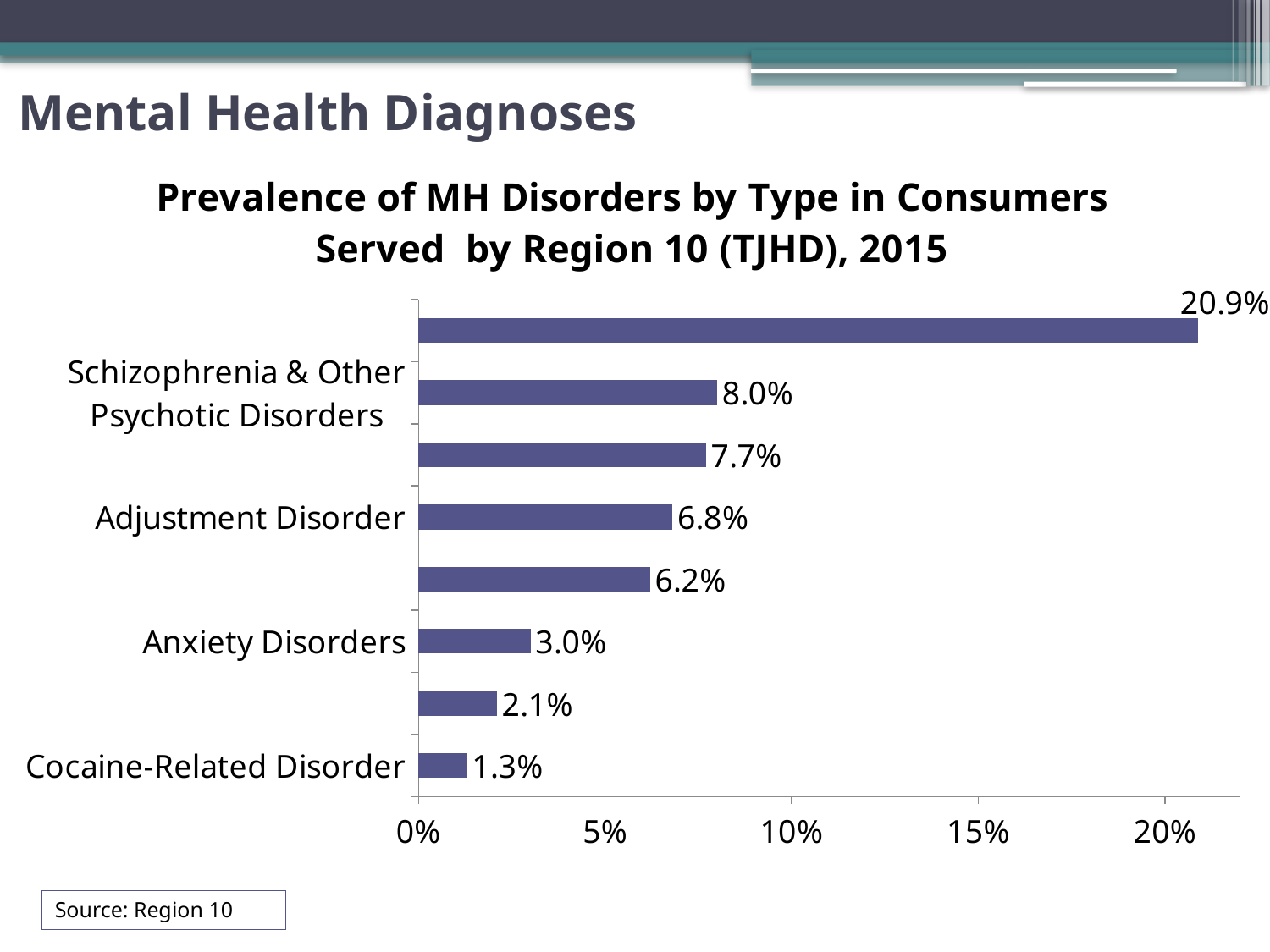
What is the value for Anxiety Disorders? 3.0% How many bars are plotted on the chart? 8 Which is larger, the value for Adjustment Disorder or the value for Anxiety Disorders? Adjustment Disorder Is the value for Schizophrenia & Other Psychotic Disorders greater or less than 5%? greater What is the difference between the values for Schizophrenia & Other Psychotic Disorders and Adjustment Disorder? 1.2% Which labeled category has the lowest value? Cocaine-Related Disorder What kind of chart is shown on the slide? Bar chart What is the value for Adjustment Disorder? 6.8% What is the value for Schizophrenia & Other Psychotic Disorders? 8.0% What is the value for Cocaine-Related Disorder? 1.3% What is the largest value shown on the chart? 20.9% What is the difference between the values for Anxiety Disorders and Cocaine-Related Disorder? 1.7%